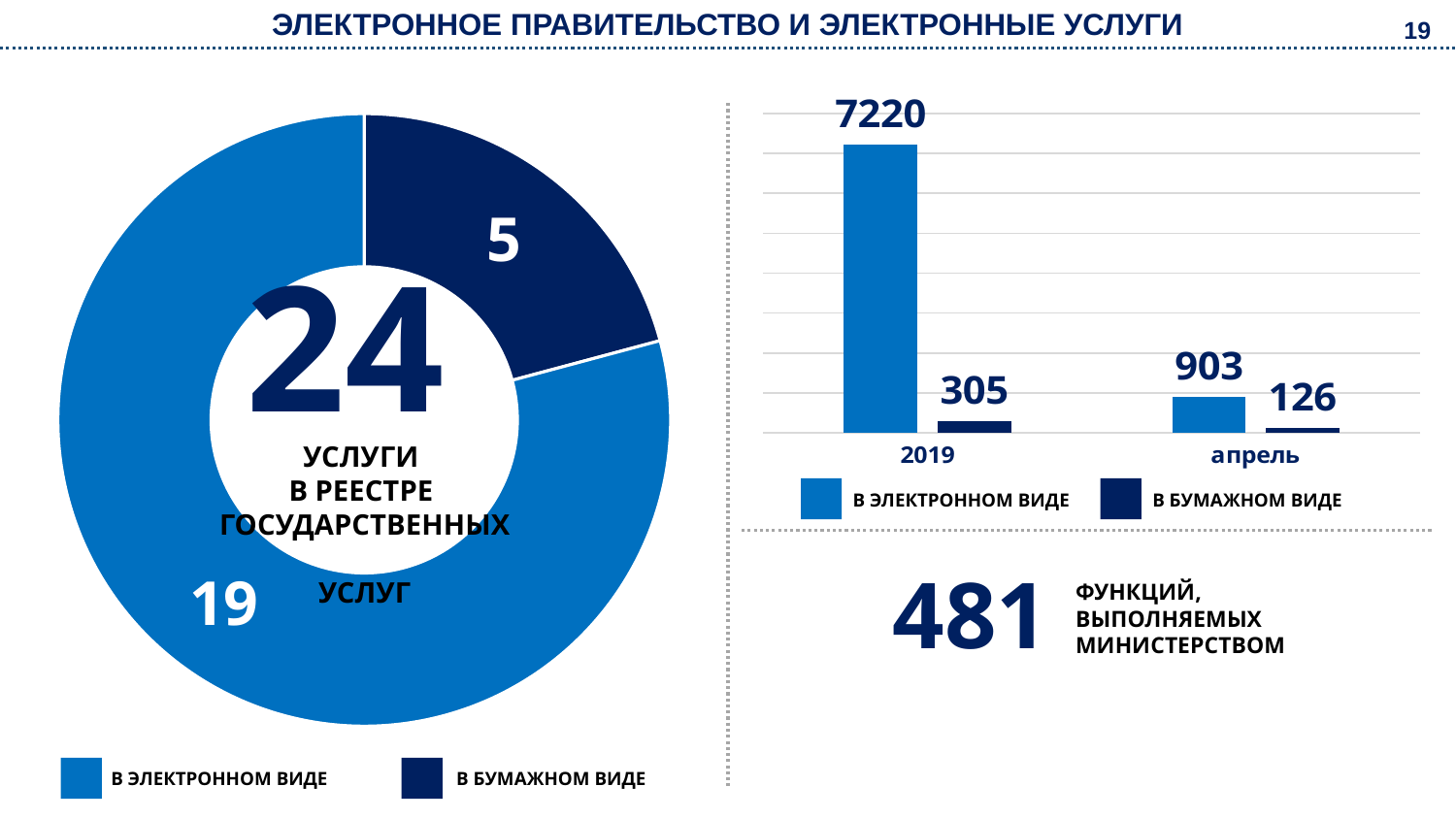
In the bar chart on the right, what is the value for 'В БУМАЖНОМ ВИДЕ' in апрель? 126 In the donut chart on the left, what is the difference between the electronic and paper values? 14 In the donut chart on the left, what total number is shown in the centre? 24 In the bar chart on the right, what is the difference between the electronic and paper values for 2019? 6915 In the bar chart on the right, how many series does the legend list? 2 In the bar chart on the right, which bar has the lowest value? В БУМАЖНОМ ВИДЕ, апрель In the donut chart on the left, what is the value for 'В БУМАЖНОМ ВИДЕ'? 5 In the donut chart on the left, which segment is larger, 'В ЭЛЕКТРОННОМ ВИДЕ' or 'В БУМАЖНОМ ВИДЕ'? В ЭЛЕКТРОННОМ ВИДЕ In the bar chart on the right, which bar has the highest value? В ЭЛЕКТРОННОМ ВИДЕ, 2019 In the bar chart on the right, what is the value for 'В ЭЛЕКТРОННОМ ВИДЕ' in 2019? 7220 What kind of chart is shown on the right side of the slide? Bar chart In the donut chart on the left, what is the value for 'В ЭЛЕКТРОННОМ ВИДЕ'? 19